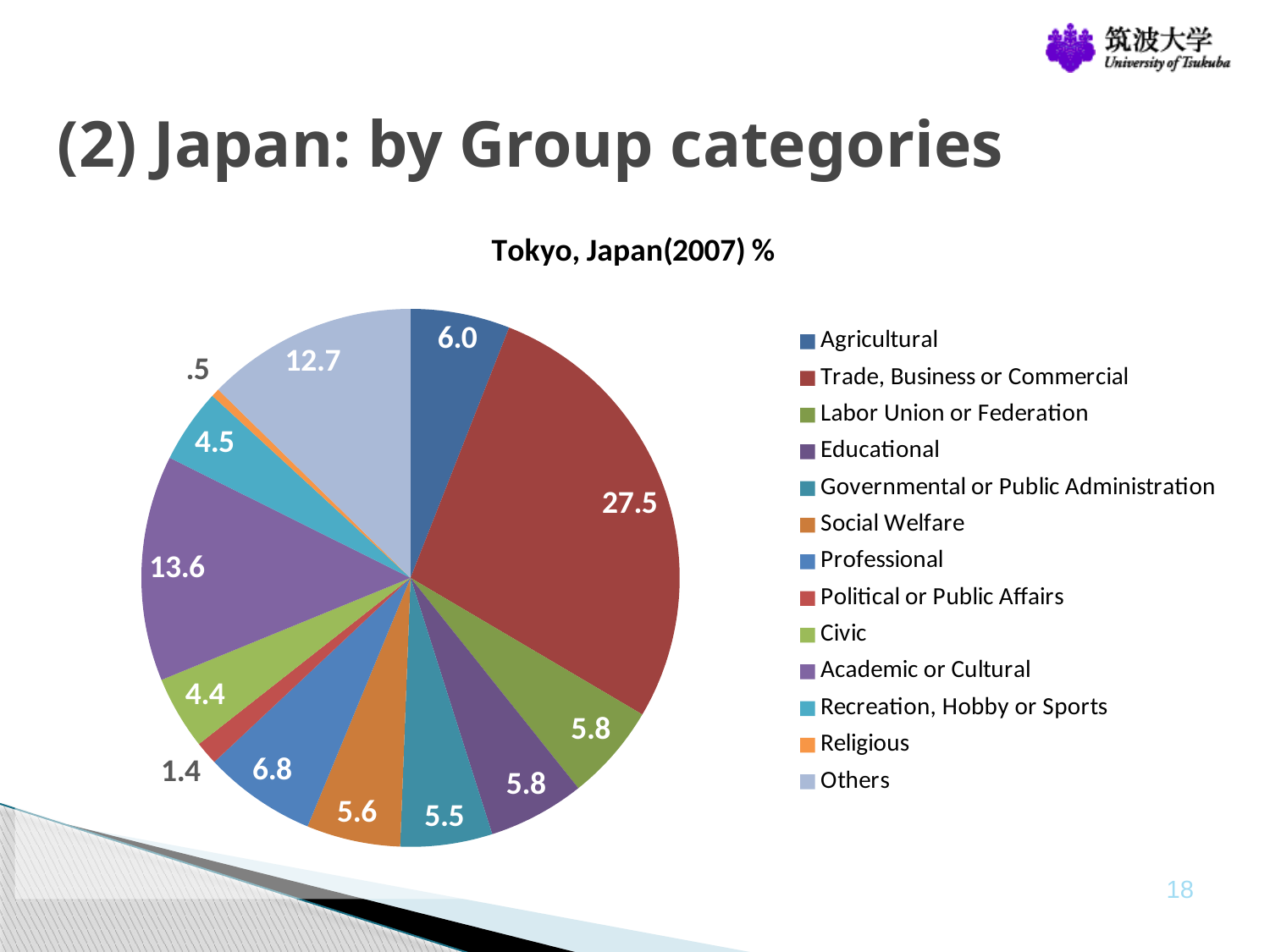
What is the value for Trade, Business or Commercial? 27.5 What type of chart is shown on the slide? pie chart What is the value for Others? 12.7 Which category has the largest share of the pie? Trade, Business or Commercial What is the value for Religious? .5 What is the difference between the values for Trade, Business or Commercial and Academic or Cultural? 13.9 How many categories does the legend list? 13 What is the value for Professional? 6.8 Which is larger, the value for Agricultural or the value for Civic? Agricultural Which category has the smallest share of the pie? Religious What is the title of the chart? Tokyo, Japan(2007) % What is the value for Academic or Cultural? 13.6